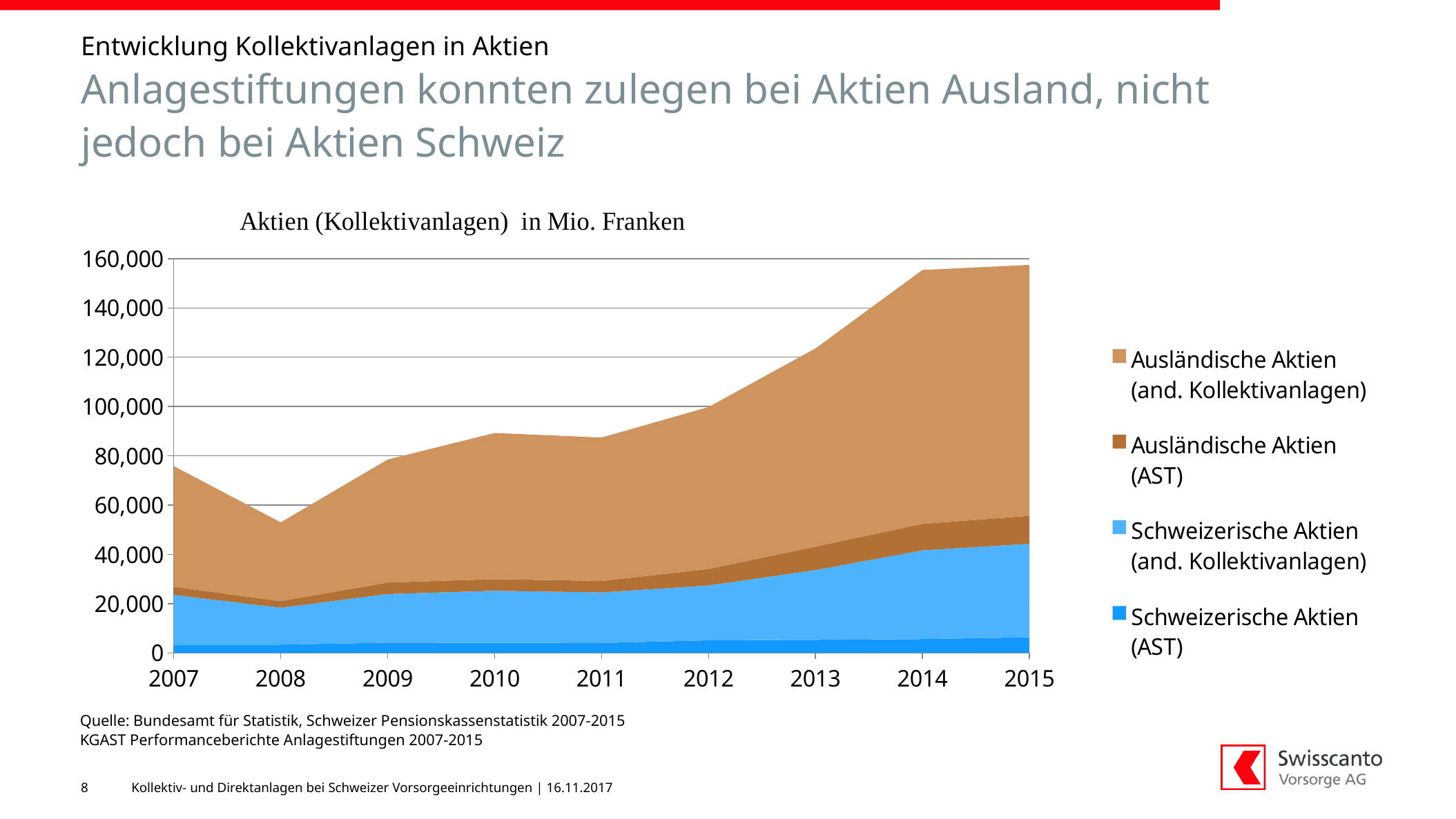
Is the total of all series in 2010 greater or less than 80,000? greater Does the total of all series rise or fall from 2007 to 2008? fall Which year has the larger total of all series, 2010 or 2013? 2013 What kind of chart is shown on the slide? Stacked area chart How many years are shown on the x axis of the chart? 9 Is the total of all series in 2014 greater or less than 140,000? greater What is the title of the chart? Aktien (Kollektivanlagen) in Mio. Franken Is the total of all series in 2008 greater or less than 60,000? less In which year is the total of all stacked series lowest? 2008 Does the total of all series rise or fall from 2011 to 2015? rise How many series does the chart's legend list? 4 Which legend entry is shown in the lightest brown colour at the top of the stacked areas? Ausländische Aktien (and. Kollektivanlagen)